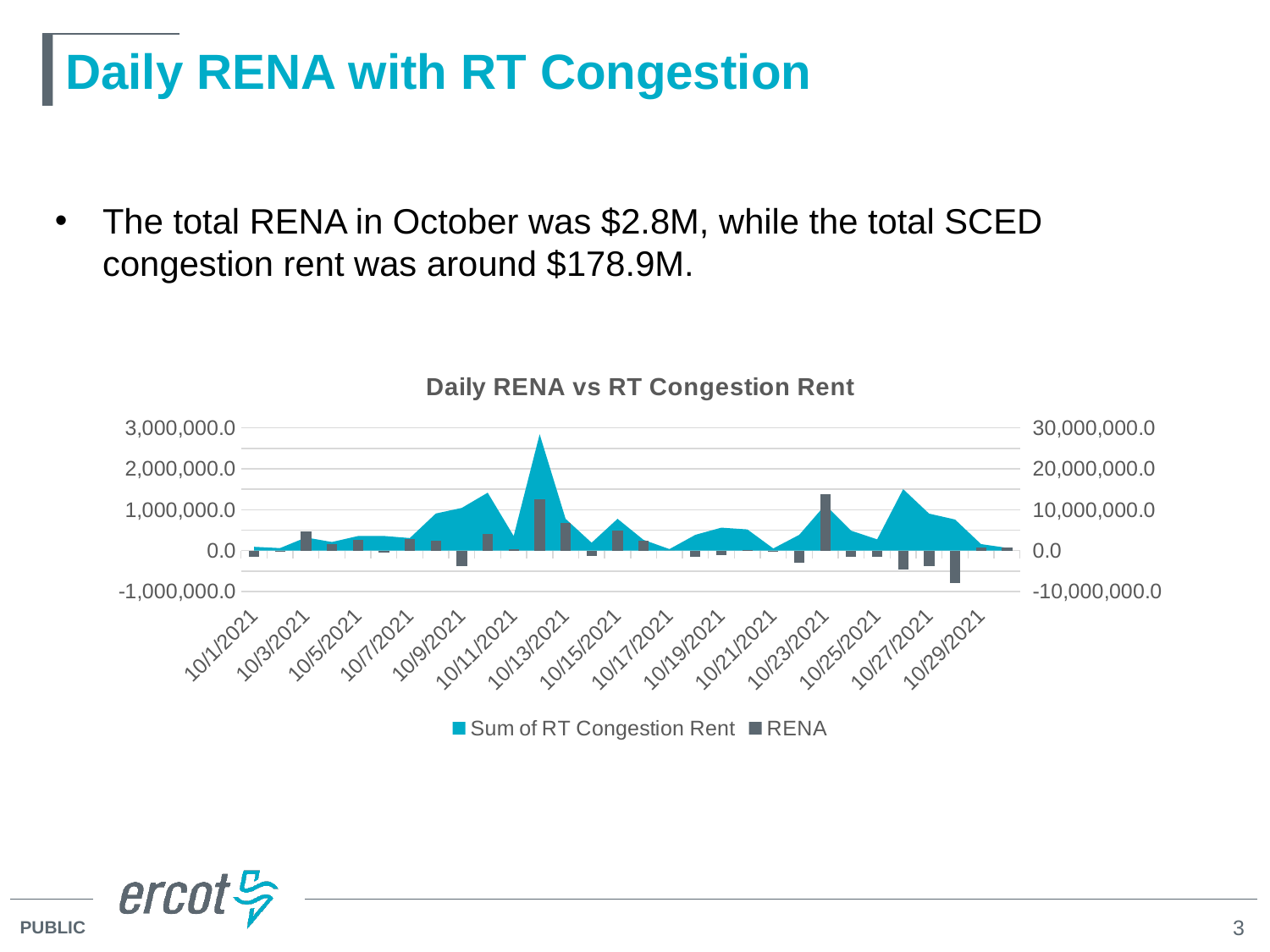
Which date has the larger Sum of RT Congestion Rent, 10/27/2021 or 10/1/2021? 10/27/2021 How many series does the chart legend list? 2 Which date has the larger RENA value, 10/23/2021 or 10/29/2021? 10/23/2021 Is the RENA value for 10/29/2021 greater or less than 1,000,000.0? less What is the title of the chart on the slide? Daily RENA vs RT Congestion Rent Is the RENA value for 10/3/2021 greater or less than 1,000,000.0? less Is the Sum of RT Congestion Rent for 10/1/2021 greater or less than 10,000,000.0? less Which series is drawn as bars in the chart? RENA What kind of chart is shown on the slide? Combination area and bar chart How many date labels are shown on the x axis of the chart? 15